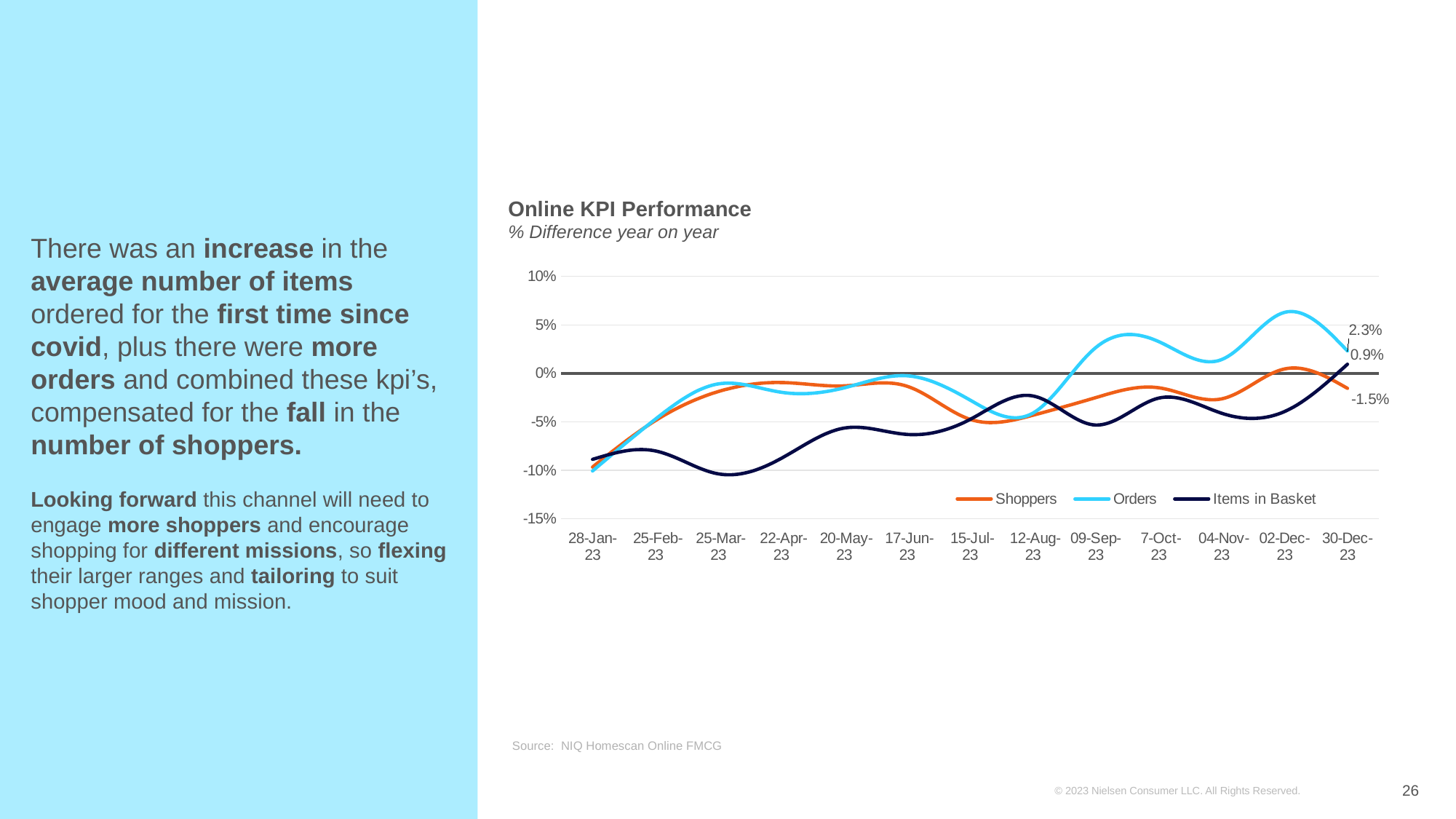
Is the value for Orders at 02-Dec-23 greater or less than 5%? greater How many dates are shown on the x axis? 13 What is the value for Orders at 30-Dec-23? 2.3% What kind of chart is shown on the slide? Line chart What is the difference between the Orders value and the Shoppers value at 30-Dec-23? 3.8 percentage points Is the value for Items in Basket at 25-Mar-23 greater or less than -5%? less What is the value for Shoppers at 30-Dec-23? -1.5% Which series has the lowest value at 30-Dec-23? Shoppers What is the value for Items in Basket at 30-Dec-23? 0.9% Which series has the highest value at 30-Dec-23? Orders How many series does the legend list? 3 At 30-Dec-23, which is larger: the value for Orders or the value for Items in Basket? Orders